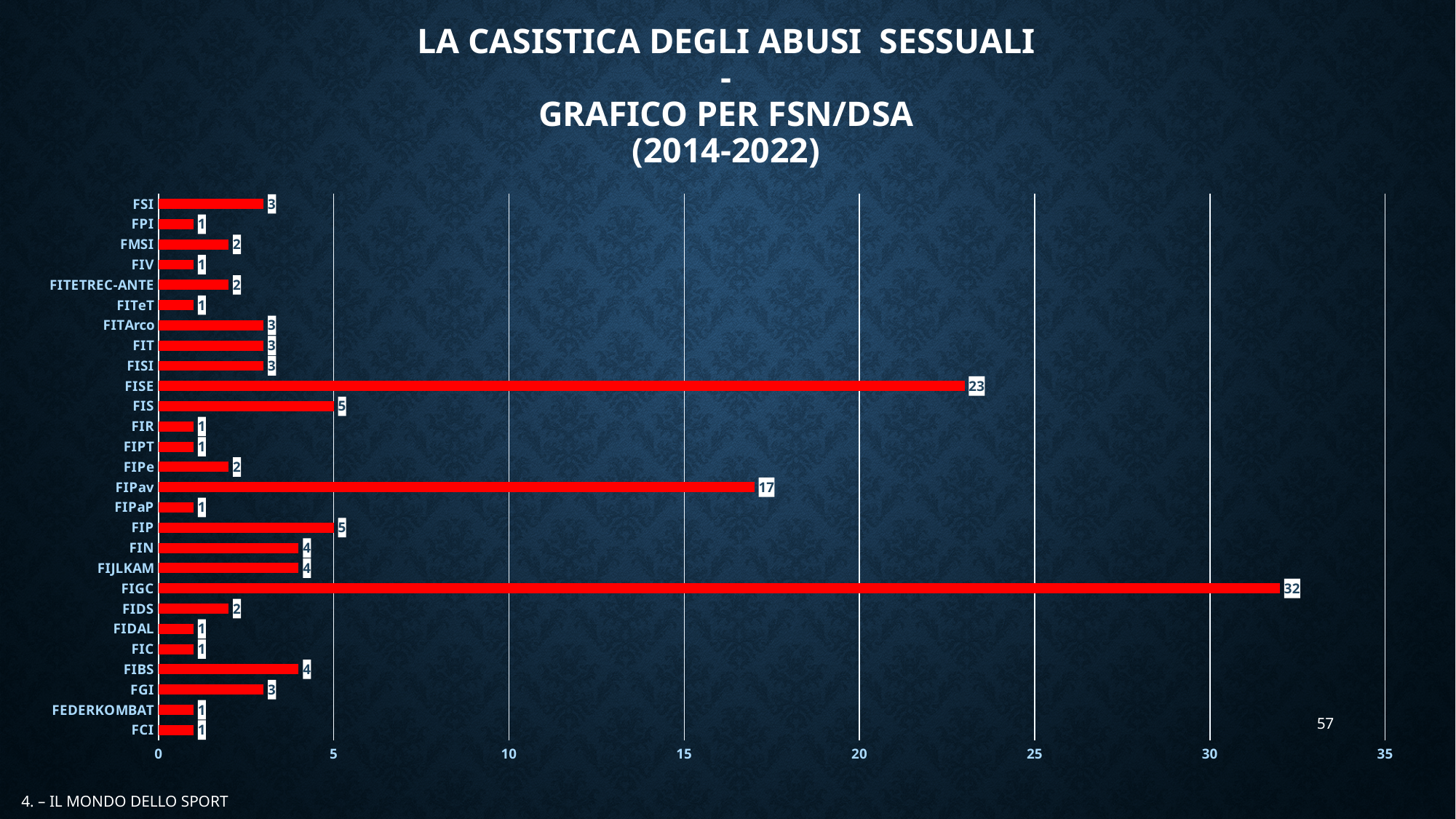
Which federation has the highest value? FIGC What kind of chart is shown on the slide? bar chart Is the value for FIGC greater or less than 30? greater What is the difference between the values for FIGC and FISE? 9 What is the difference between the values for FISE and FIPav? 6 What is the value for FIBS? 4 How many federations are shown on the chart? 27 What period does the chart title say the data covers? 2014-2022 Which is larger, the value for FIS or the value for FIN? FIS What is the value for FIPav? 17 What is the value for FISE? 23 What is the value for FIGC? 32